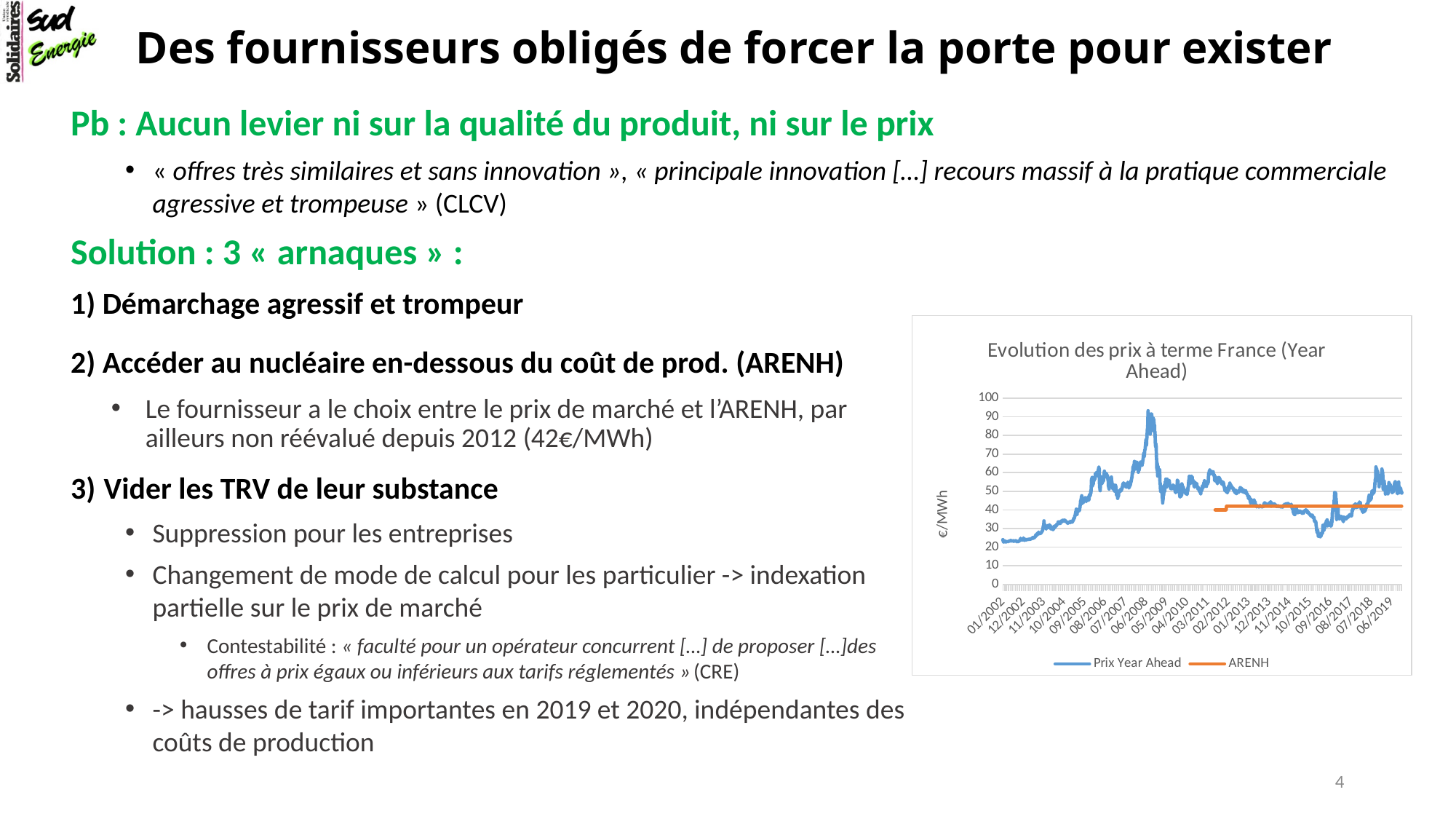
How many series does the legend of the chart list? 2 Which series is drawn in orange in the chart? ARENH Is the peak value of the Prix Year Ahead series, reached around 2008, greater or less than 80? greater Around 2016, which series has the larger value: Prix Year Ahead or ARENH? ARENH Does the Prix Year Ahead series rise or fall between 01/2002 and its peak in 2008? rise What kind of chart is shown on the slide? line chart Is the value of the ARENH series greater or less than 50? less What is the title of the chart? Evolution des prix à terme France (Year Ahead) Is the value of the ARENH series greater or less than 30? greater What unit is shown on the y-axis of the chart? €/MWh